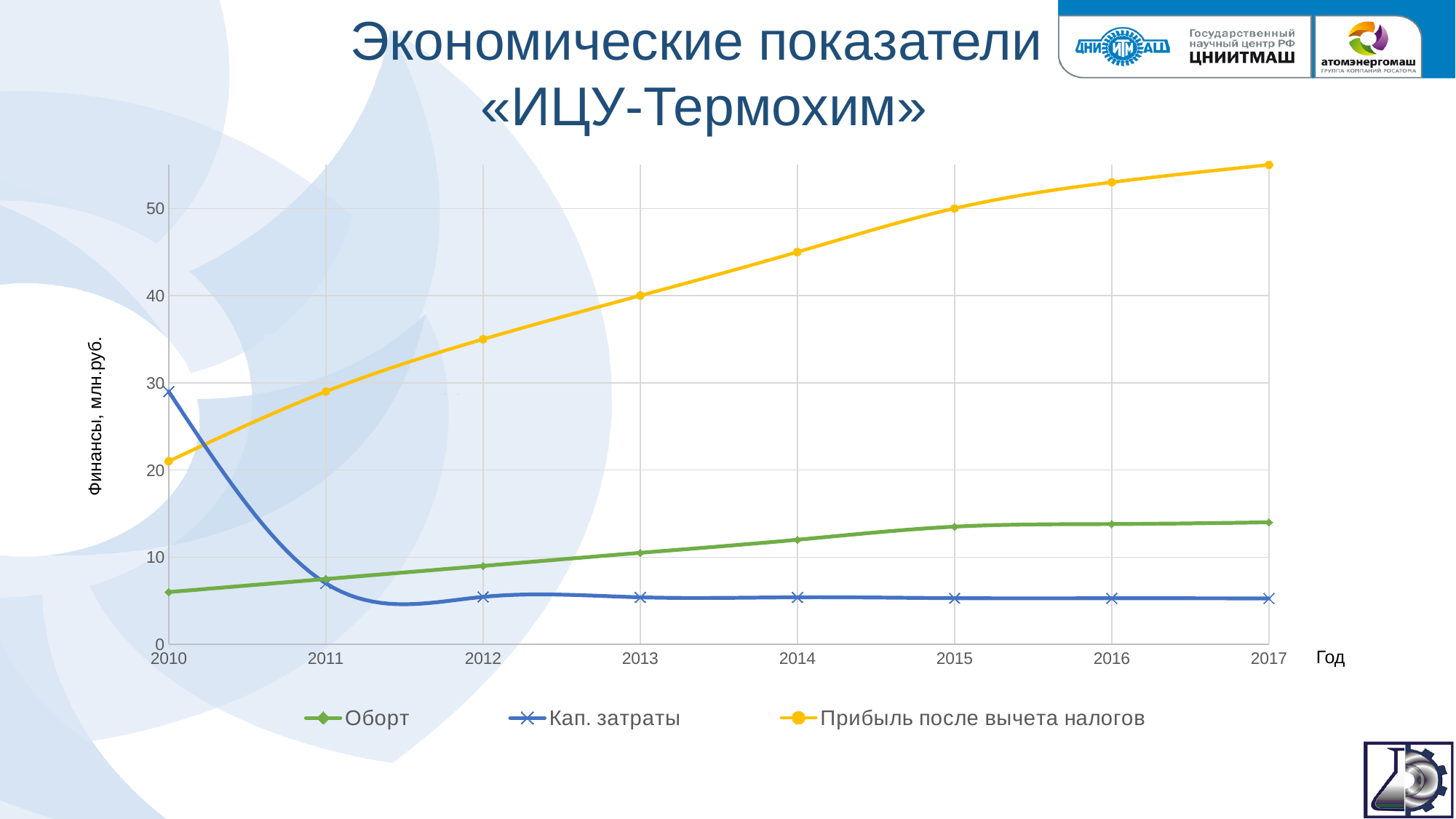
What is the value of Прибыль после вычета налогов in 2015? 50 How many series does the legend list? 3 Is the value for Кап. затраты in 2017 greater or less than 10? less Which series has the highest value in 2017? Прибыль после вычета налогов What is the value of Прибыль после вычета налогов in 2013? 40 Is the value for Кап. затраты in 2010 greater or less than 20? greater Does Прибыль после вычета налогов rise or fall from 2010 to 2017? rise What is the label of the y axis? Финансы, млн.руб. In 2010, which is larger: Оборт or Кап. затраты? Кап. затраты How many years are shown on the x axis? 8 What kind of chart is shown on the slide? line chart Is the value for Прибыль после вычета налогов in 2017 greater or less than 50? greater